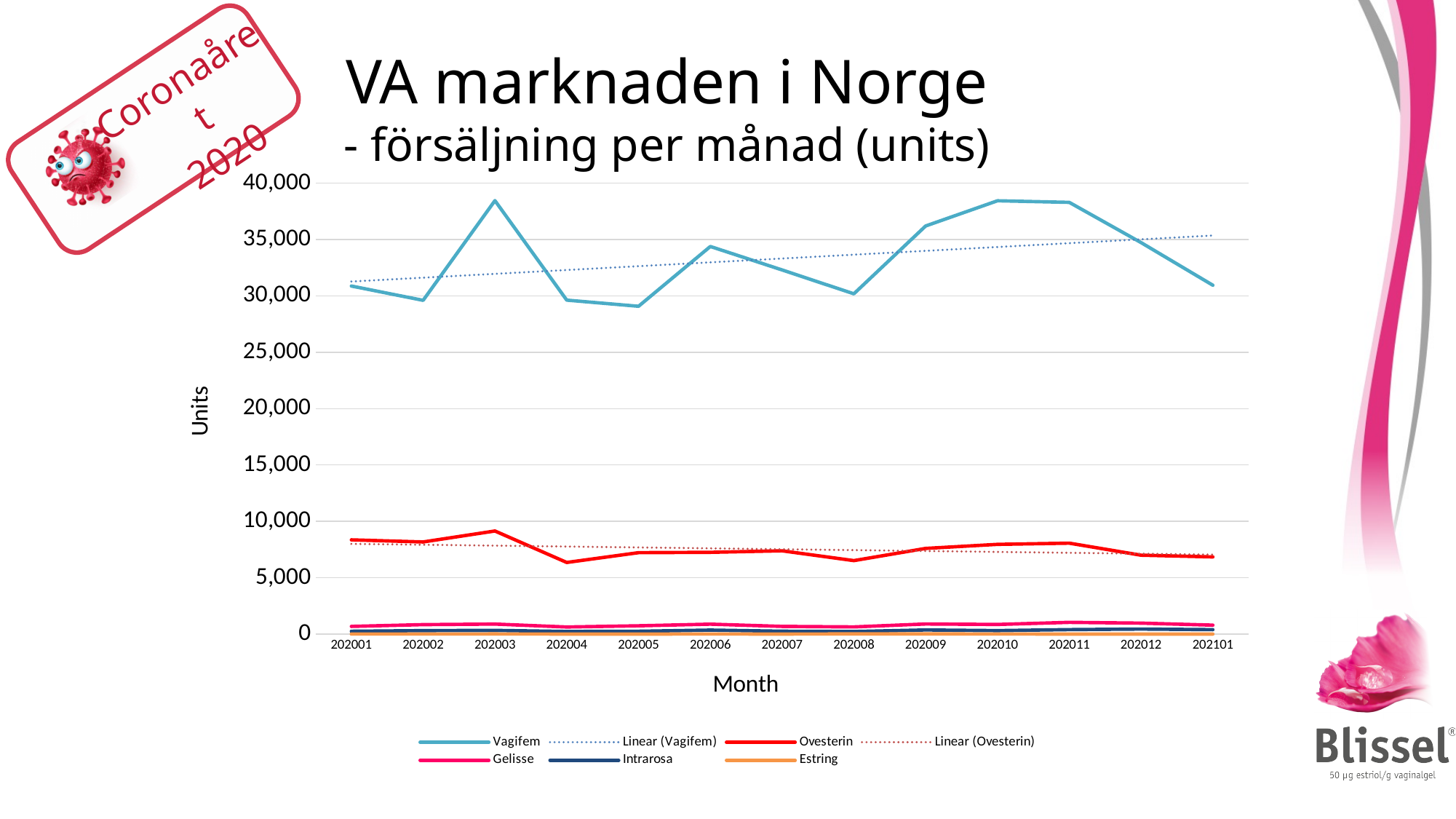
Is the value for Ovesterin in 202004 greater or less than 5,000? greater Does the Linear (Vagifem) trend line rise or fall from 202001 to 202101? rise Is the value for Vagifem in 202005 greater or less than 30,000? less Is the value for Ovesterin in 202003 greater or less than 10,000? less Which series has the larger value in 202008, Vagifem or Ovesterin? Vagifem What kind of chart is shown on the slide? line chart How many entries does the legend list? 7 How many months are plotted along the x axis? 13 In which month does Ovesterin reach its highest value? 202003 What is the label of the vertical axis? Units